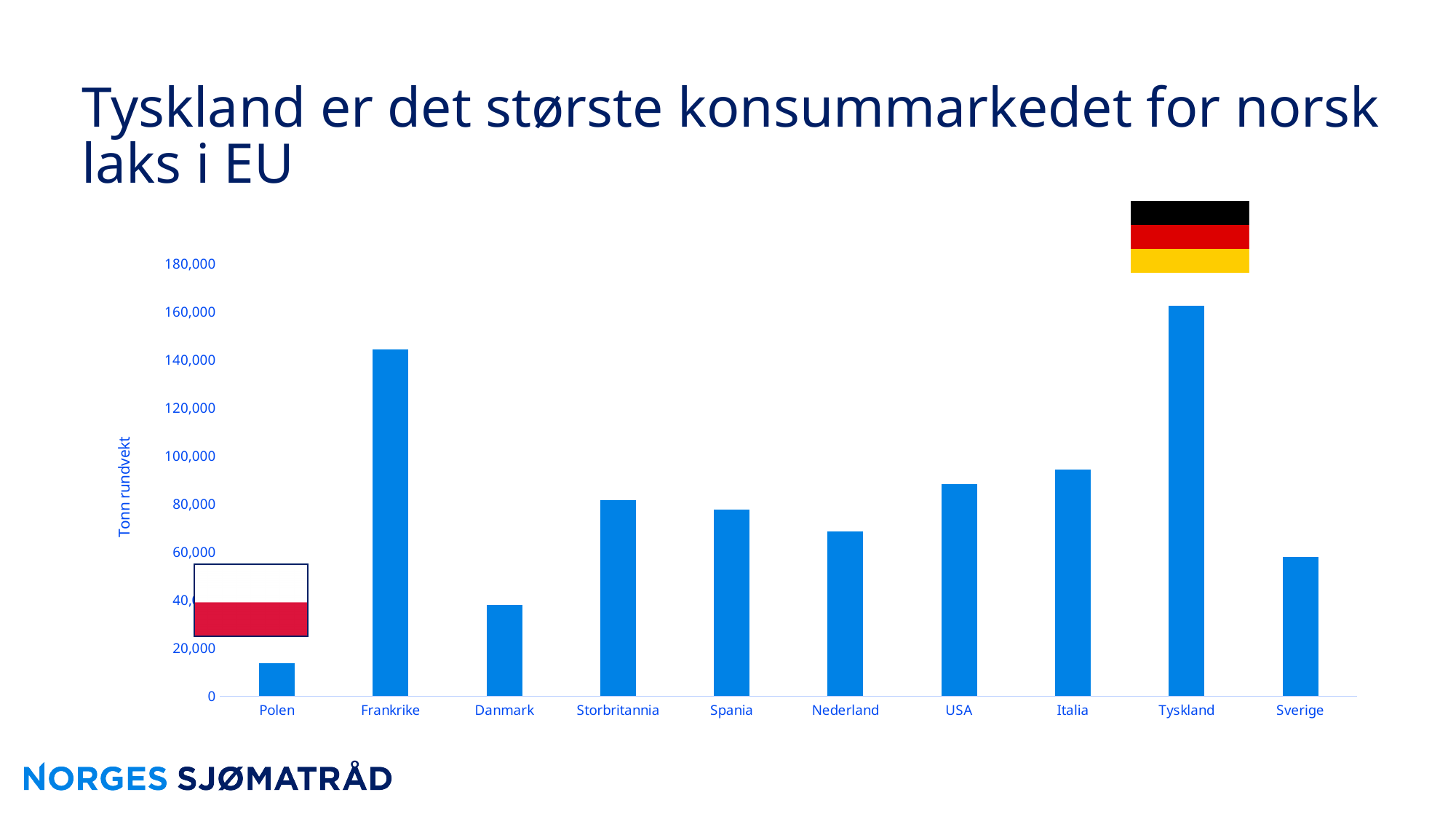
Which country has the highest value in the chart? Tyskland What kind of chart is shown on the slide? bar chart Is the value for Tyskland greater or less than 140,000? greater Is the value for Italia greater or less than 80,000? greater Which country has the lowest value in the chart? Polen What is the label on the vertical axis of the chart? Tonn rundvekt How many countries are shown on the x axis of the chart? 10 Is the value for Nederland greater or less than 80,000? less Which has the larger value, Frankrike or Tyskland? Tyskland Which has the larger value, USA or Nederland? USA